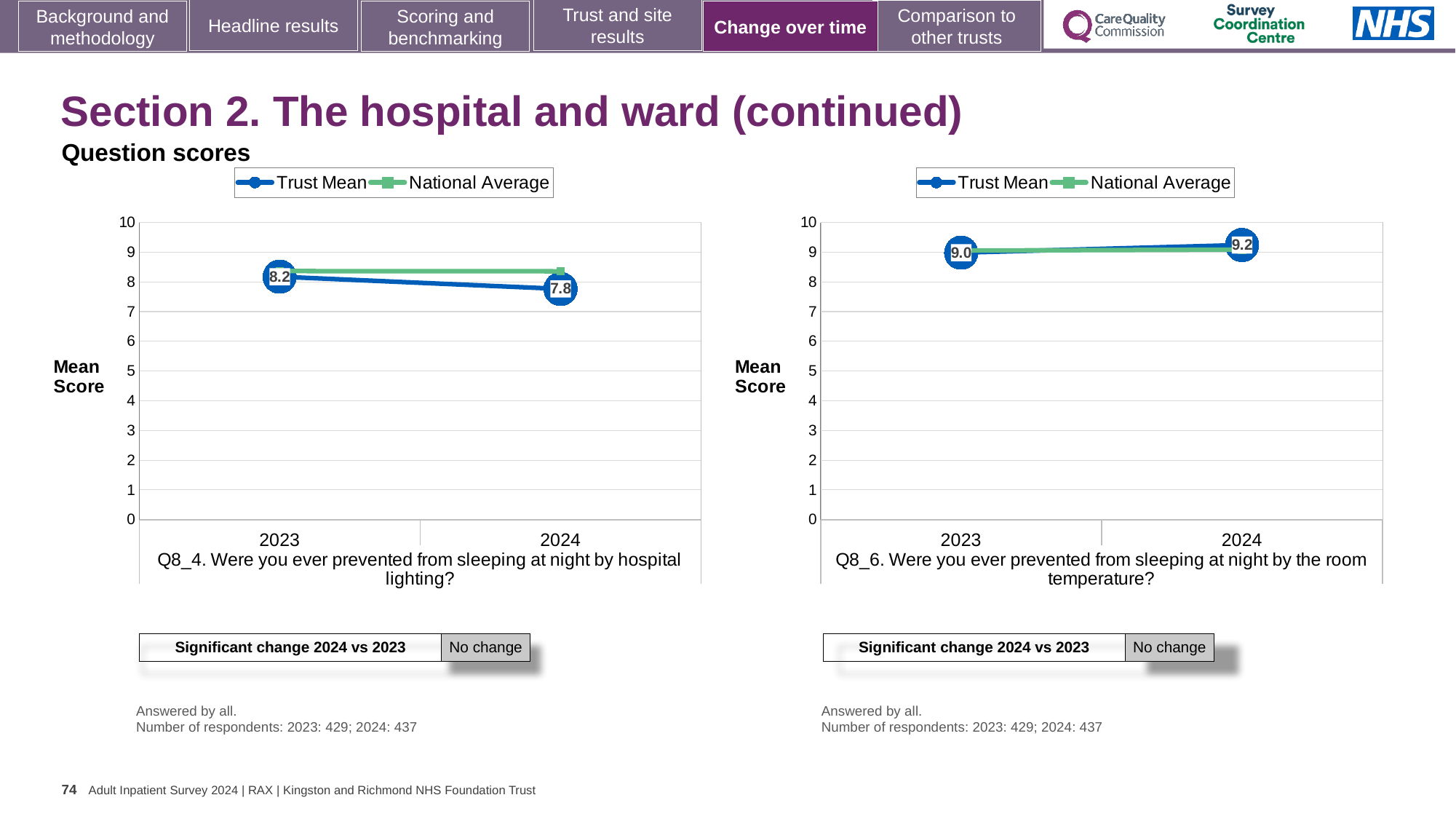
In the Q8_4 hospital lighting chart, which is higher in 2024, the Trust Mean or the National Average? National Average In the Q8_6 room temperature chart, what is the difference between the Trust Mean for 2024 and 2023? 0.2 In the Q8_4 hospital lighting chart, what is the Trust Mean for 2024? 7.8 In the Q8_4 hospital lighting chart, does the Trust Mean rise or fall from 2023 to 2024? fall In the Q8_6 room temperature chart, what is the Trust Mean for 2024? 9.2 In the Q8_4 hospital lighting chart, is the National Average for 2024 greater or less than 8? greater In the Q8_6 room temperature chart, what is the Trust Mean for 2023? 9.0 What kind of chart is the Q8_4 hospital lighting chart? line chart In the Q8_4 hospital lighting chart, what is the Trust Mean for 2023? 8.2 How many series does the legend of the Q8_6 room temperature chart list? 2 In the Q8_6 room temperature chart, does the Trust Mean rise or fall from 2023 to 2024? rise In the Q8_4 hospital lighting chart, by how much did the Trust Mean change from 2023 to 2024? 0.4